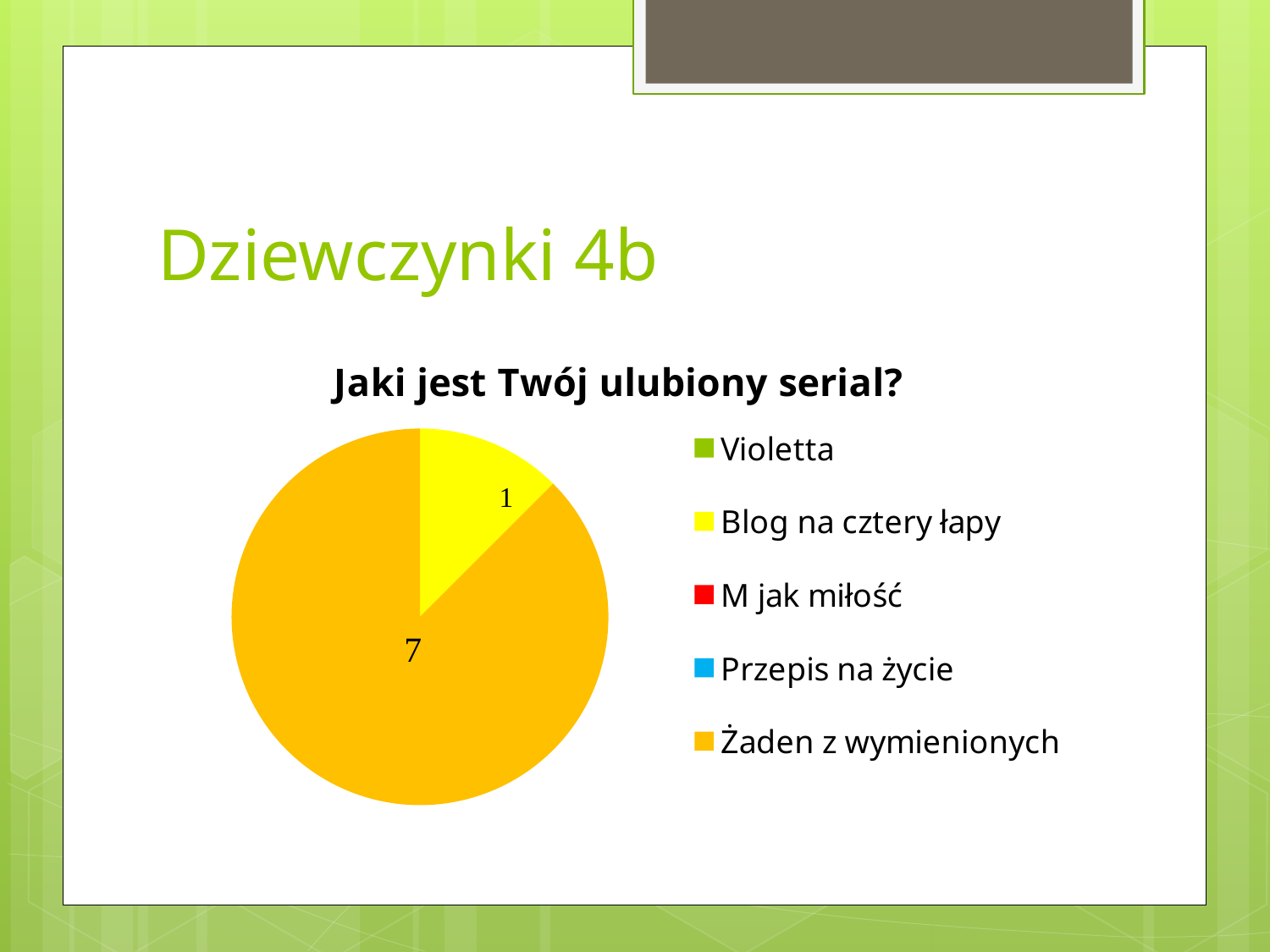
What share of the pie does "Żaden z wymienionych" represent? 87.5% How many entries does the chart's legend list? 5 What is the title of the chart? Jaki jest Twój ulubiony serial? Which category has the largest slice of the pie? Żaden z wymienionych What value is shown for "Blog na cztery łapy"? 1 What type of chart is shown on the slide? pie chart How many slices are visible in the pie chart? 2 What is the difference between the values for "Żaden z wymienionych" and "Blog na cztery łapy"? 6 What colour represents "Blog na cztery łapy" in the legend? yellow What value is shown for "Żaden z wymienionych"? 7 Which is larger, the value for "Blog na cztery łapy" or the value for "Żaden z wymienionych"? Żaden z wymienionych